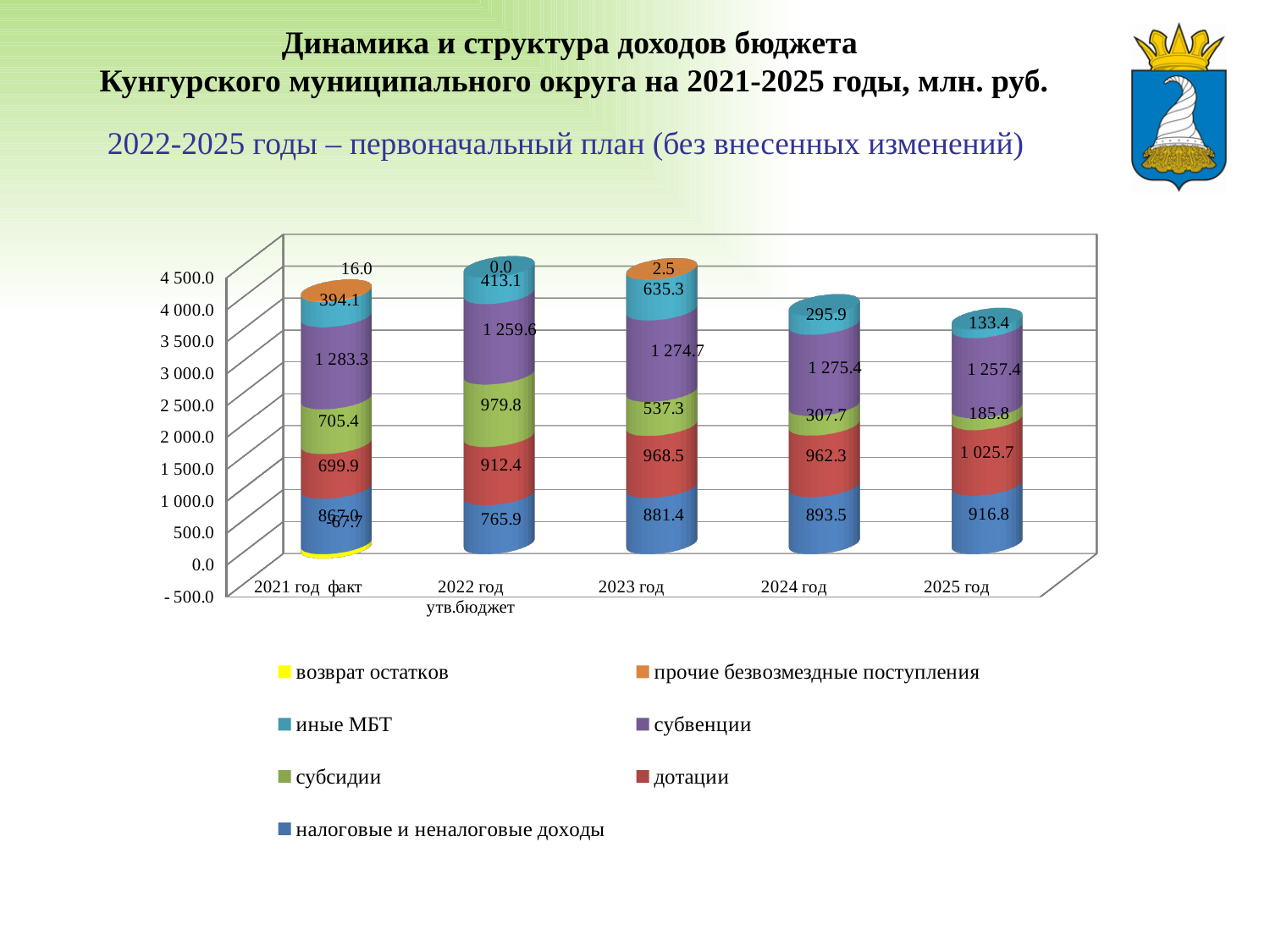
From 2022 год onward, do the values of субсидии rise or fall along the x axis? Fall What is the value of налоговые и неналоговые доходы for 2025 год? 916.8 What kind of chart is shown on the slide? Stacked bar chart Which is larger: субсидии in 2022 год утв.бюджет or субсидии in 2023 год? 2022 год утв.бюджет In which year is the value of иные МБТ the highest? 2023 год What is the difference between дотации in 2025 год and 2024 год? 63.4 What is the value of иные МБТ for 2022 год утв.бюджет? 413.1 In which year is the value of субсидии the lowest? 2025 год What is the value of субвенции for 2023 год? 1 274.7 How many year categories are shown on the x axis? 5 What is the value of возврат остатков for 2021 год факт? -67.7 How many series does the legend list? 7